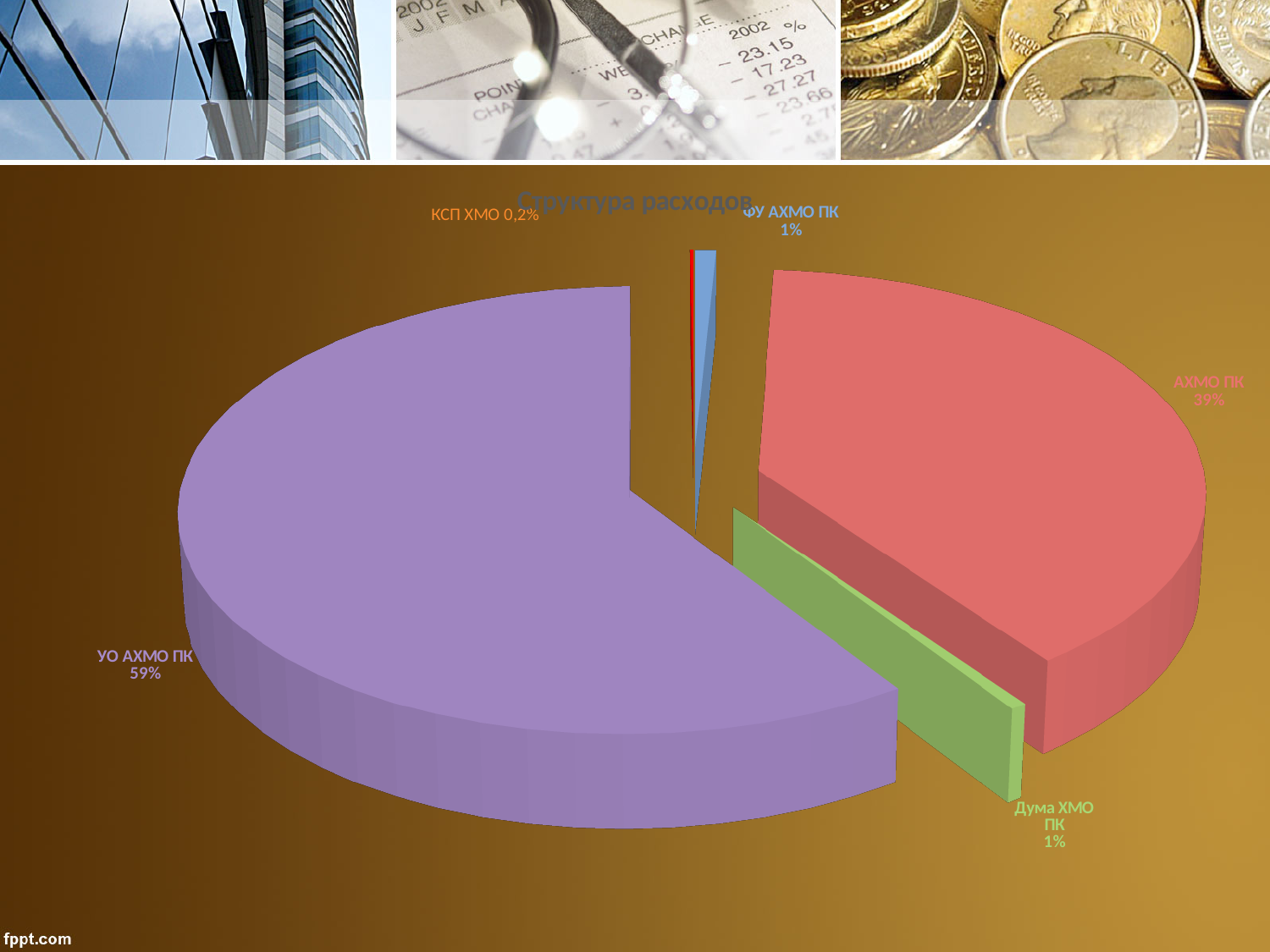
Which category has the smallest slice of the pie? КСП ХМО What share of the pie does Дума ХМО ПК have? 1% What is the difference in percentage points between УО АХМО ПК and АХМО ПК? 20 How many slices does the pie chart have? 5 What share of the pie does ФУ АХМО ПК have? 1% What is the title of the chart? Структура расходов What share of the pie does УО АХМО ПК have? 59% Which is larger, the slice for АХМО ПК or the slice for Дума ХМО ПК? АХМО ПК What share of the pie does КСП ХМО have? 0,2% What kind of chart is shown on the slide? pie chart What share of the pie does АХМО ПК have? 39% Which category has the largest slice of the pie? УО АХМО ПК